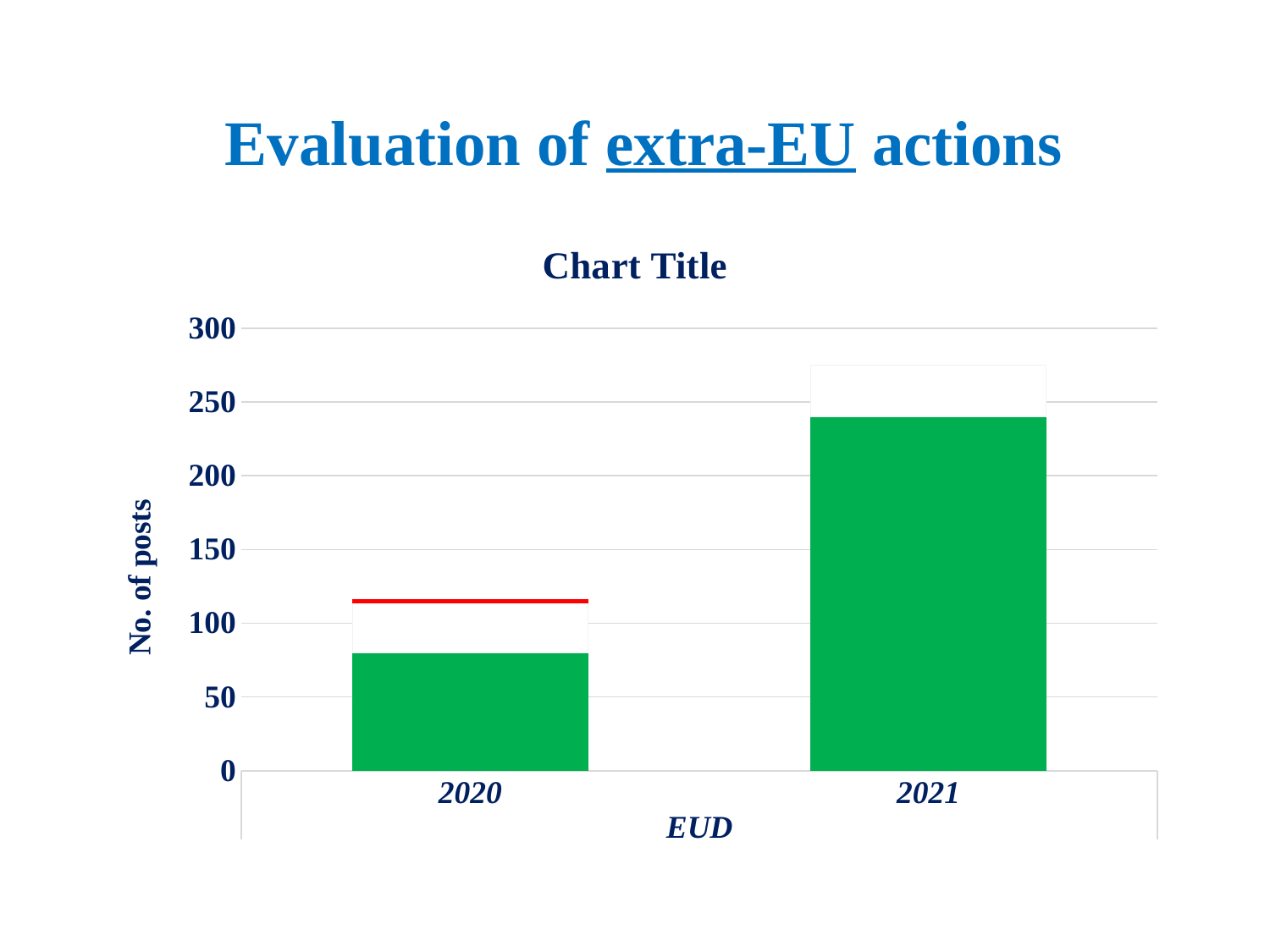
What is the label on the horizontal axis? EUD What kind of chart is shown on the slide? bar chart Is the top of the stacked bar for 2021 greater or less than 250? greater What is the label on the vertical axis? No. of posts Which category has the shorter green bar? 2020 Is the top of the stacked bar for 2020 greater or less than 150? less Is the green bar for 2020 greater or less than 100? less Do the bar values rise or fall from 2020 to 2021? rise How many categories are shown on the x axis? 2 Which category has the taller green bar, 2020 or 2021? 2021